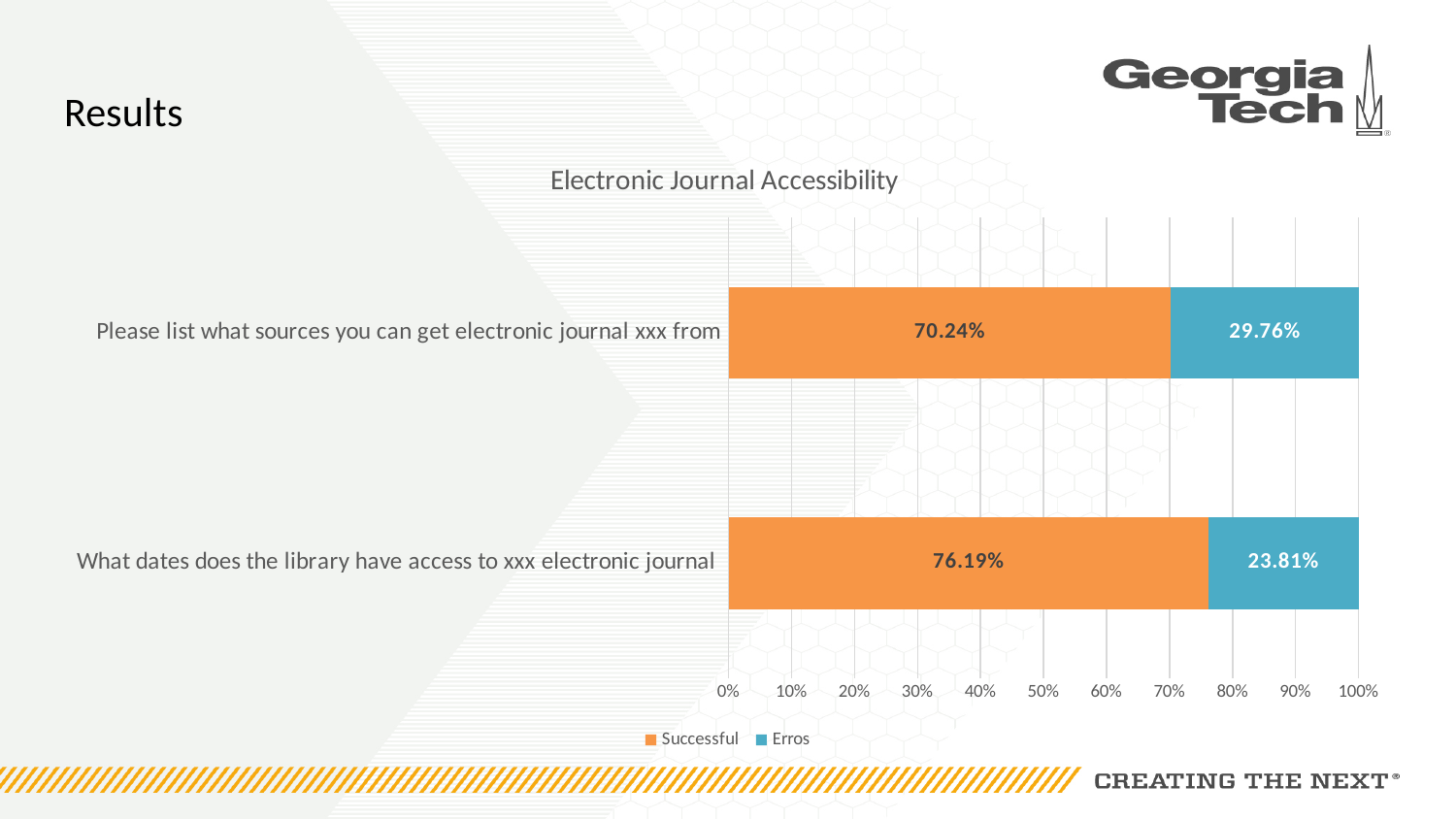
Which category has the lowest Erros value? What dates does the library have access to xxx electronic journal How many series does the legend list? 2 What is the difference between the Successful values of the two categories? 5.95% What is the title of the chart? Electronic Journal Accessibility What is the Erros value for "Please list what sources you can get electronic journal xxx from"? 29.76% Is the Successful value for "What dates does the library have access to xxx electronic journal" greater or less than 70%? greater Is the Successful value for "Please list what sources you can get electronic journal xxx from" larger than the Successful value for "What dates does the library have access to xxx electronic journal"? No Which category has the highest Successful value? What dates does the library have access to xxx electronic journal What is the Erros value for "What dates does the library have access to xxx electronic journal"? 23.81% What is the Successful value for "Please list what sources you can get electronic journal xxx from"? 70.24% What kind of chart is shown on the slide? Stacked bar chart How many categories are shown in the chart? 2